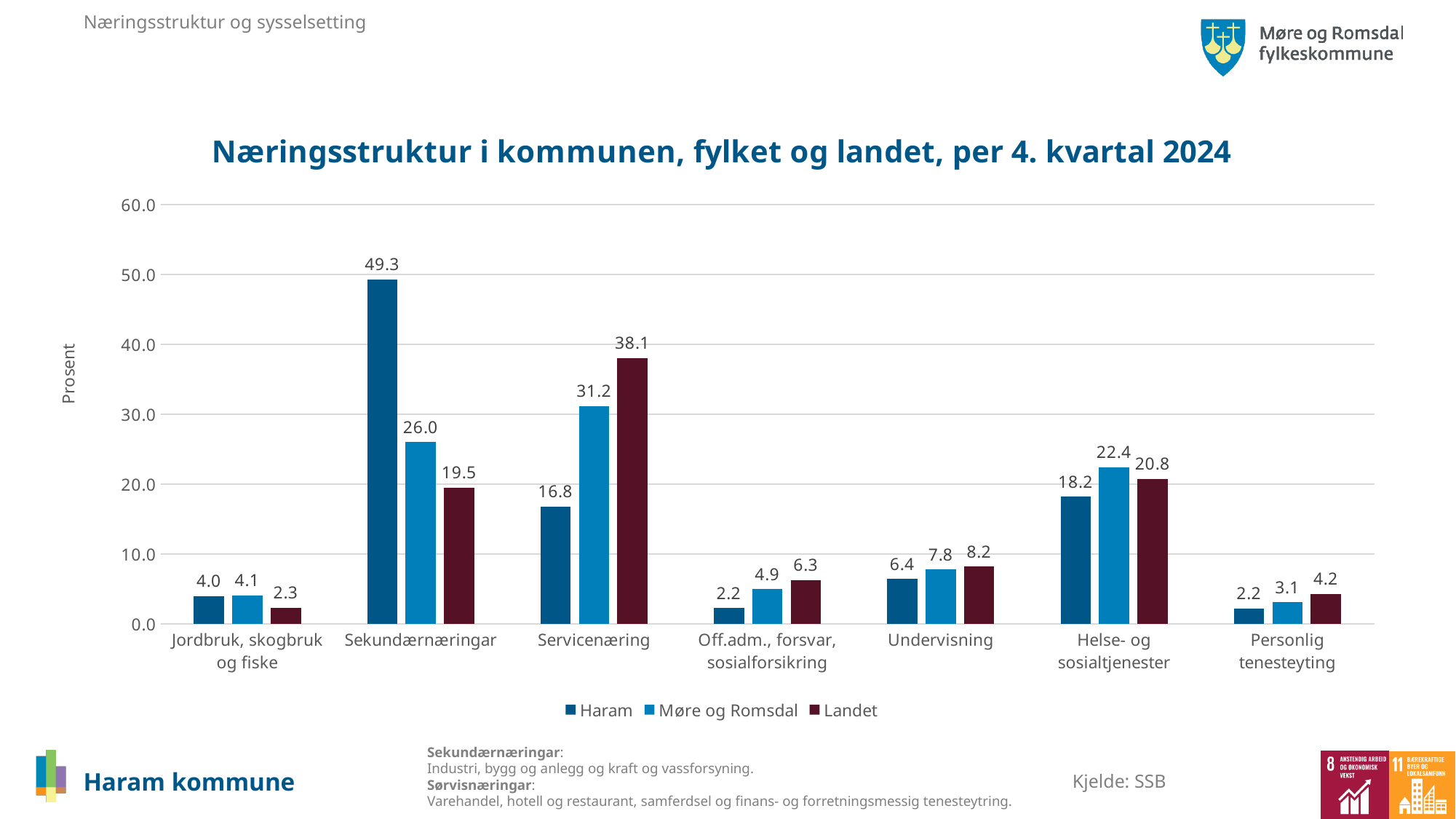
What is the value for Møre og Romsdal in Helse- og sosialtjenester? 22.4 How many series does the legend list? 3 Which category has the lowest value for Landet? Jordbruk, skogbruk og fiske Which is larger in Undervisning: the value for Haram or the value for Landet? Landet What is the value for Haram in Sekundærnæringar? 49.3 What kind of chart is shown on the slide? Bar chart What is the label of the y axis? Prosent What is the value for Landet in Servicenæring? 38.1 How many categories are shown on the x axis? 7 Which category has the highest value for Haram? Sekundærnæringar What is the difference between the Haram and Landet values in Sekundærnæringar? 29.8 Is the value for Møre og Romsdal in Servicenæring greater or less than 30.0? greater